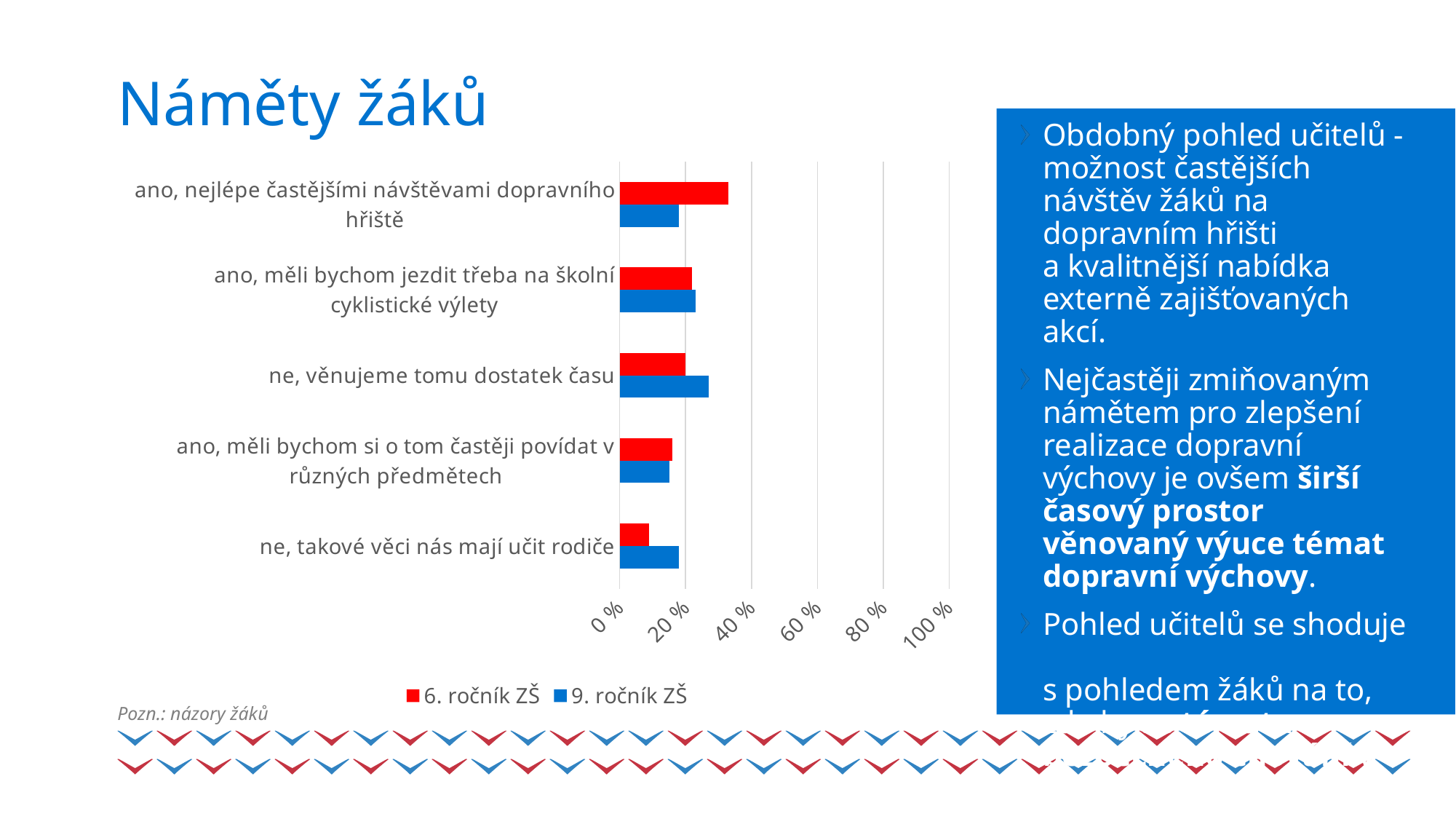
How many series does the legend list? 2 Is the 9. ročník ZŠ value for 'ne, věnujeme tomu dostatek času' greater or less than 20 %? greater Which colour represents the 6. ročník ZŠ series in the legend? red For 'ne, takové věci nás mají učit rodiče', which series has the larger value, 6. ročník ZŠ or 9. ročník ZŠ? 9. ročník ZŠ For 'ano, nejlépe častějšími návštěvami dopravního hřiště', which series has the larger value, 6. ročník ZŠ or 9. ročník ZŠ? 6. ročník ZŠ How many categories does the chart show? 5 Is the 6. ročník ZŠ value for 'ne, takové věci nás mají učit rodiče' greater or less than 20 %? less Is the 6. ročník ZŠ value for 'ano, nejlépe častějšími návštěvami dopravního hřiště' greater or less than 20 %? greater What is the title of the slide containing the chart? Náměty žáků What kind of chart is shown on the slide? bar chart Which category has the lowest value for the 6. ročník ZŠ series? ne, takové věci nás mají učit rodiče Which category has the highest value for the 6. ročník ZŠ series? ano, nejlépe častějšími návštěvami dopravního hřiště